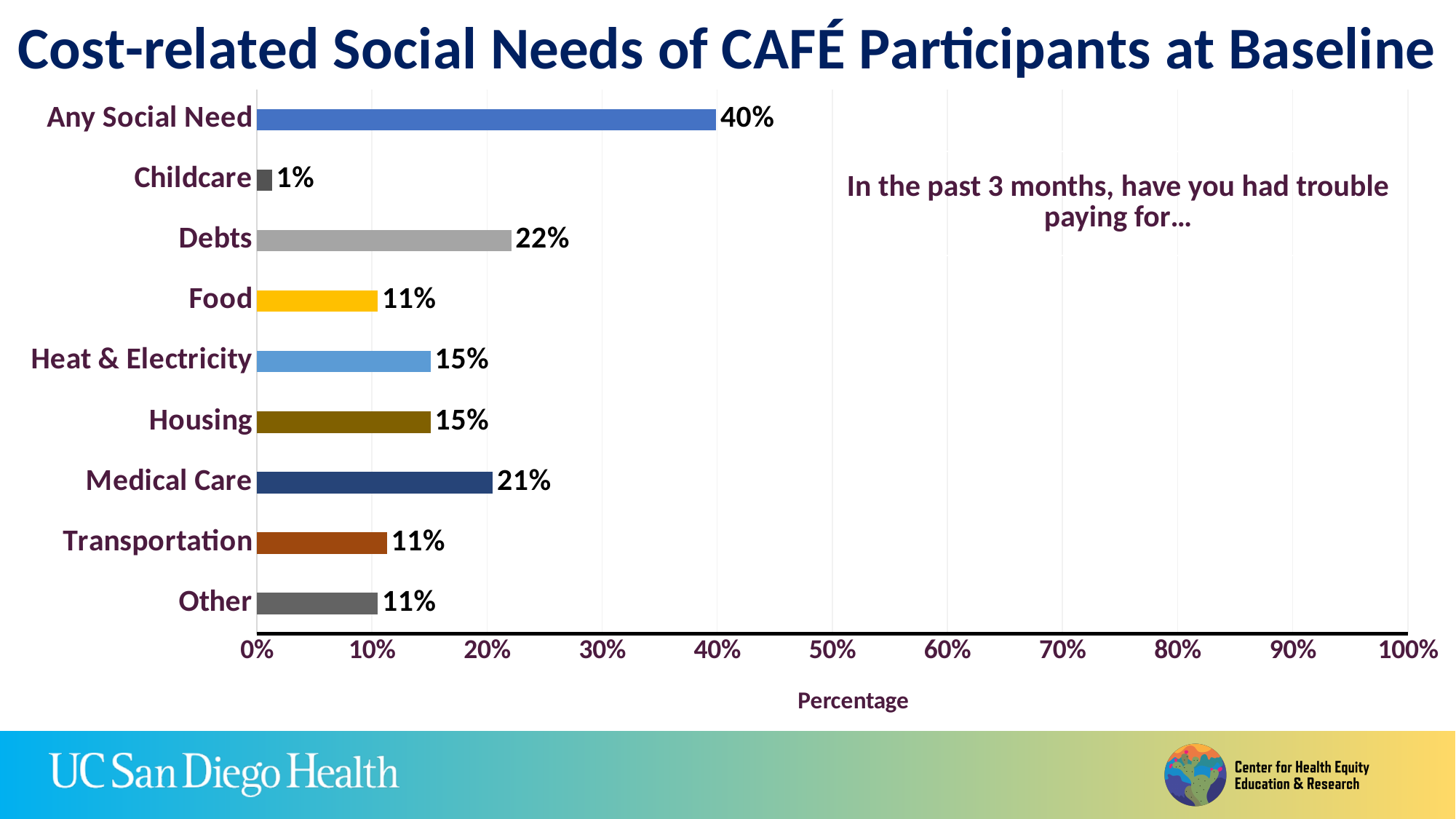
What is the title of the chart? Cost-related Social Needs of CAFÉ Participants at Baseline What is the difference between the values for Debts and Food? 11% Which category has the highest value? Any Social Need What percentage is shown for Medical Care? 21% Which category has the lowest value? Childcare Is the value for Any Social Need greater or less than 30%? greater Which is larger, the value for Medical Care or the value for Heat & Electricity? Medical Care How many categories are shown on the chart? 9 What percentage of participants reported trouble paying for Debts? 22% What is the label on the horizontal axis? Percentage What is the value shown for Any Social Need? 40% What kind of chart is shown on the slide? bar chart